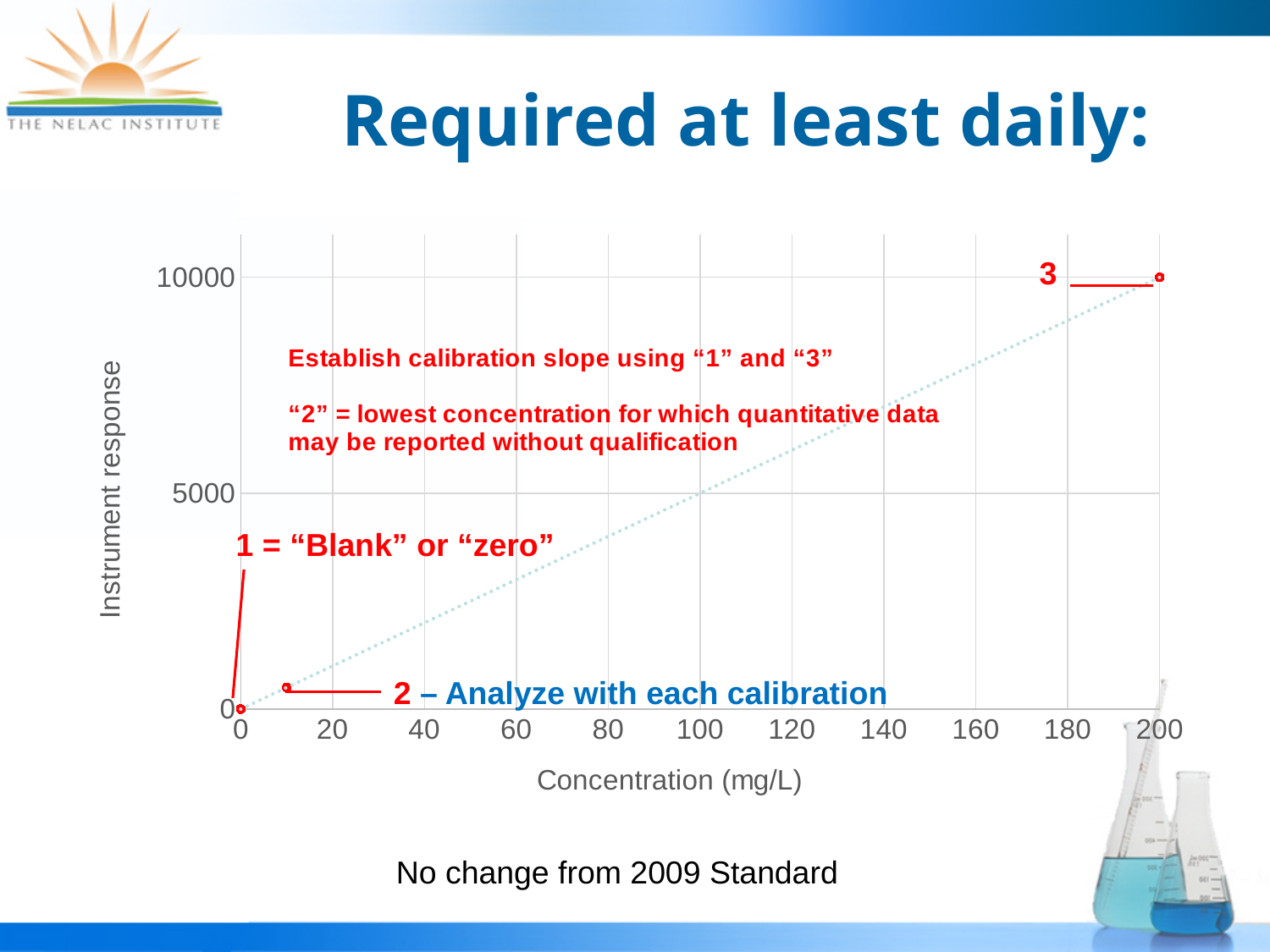
What is the title of the x axis? Concentration (mg/L) What kind of chart is shown on the slide? scatter chart What is the difference in instrument response between point "3" and point "1"? 10000 Does the instrument response rise or fall as concentration increases along the x axis? rise What is the instrument response for point "3"? 10000 What is the concentration (mg/L) for point "3"? 200 Is the instrument response for point "2" greater or less than 5000? less Which point has the highest instrument response? 3 Which point has the lowest instrument response? 1 Is the concentration for point "2" greater or less than 20 mg/L? less What is the instrument response for point "1" (the blank)? 0 How many data points are plotted on the chart? 3